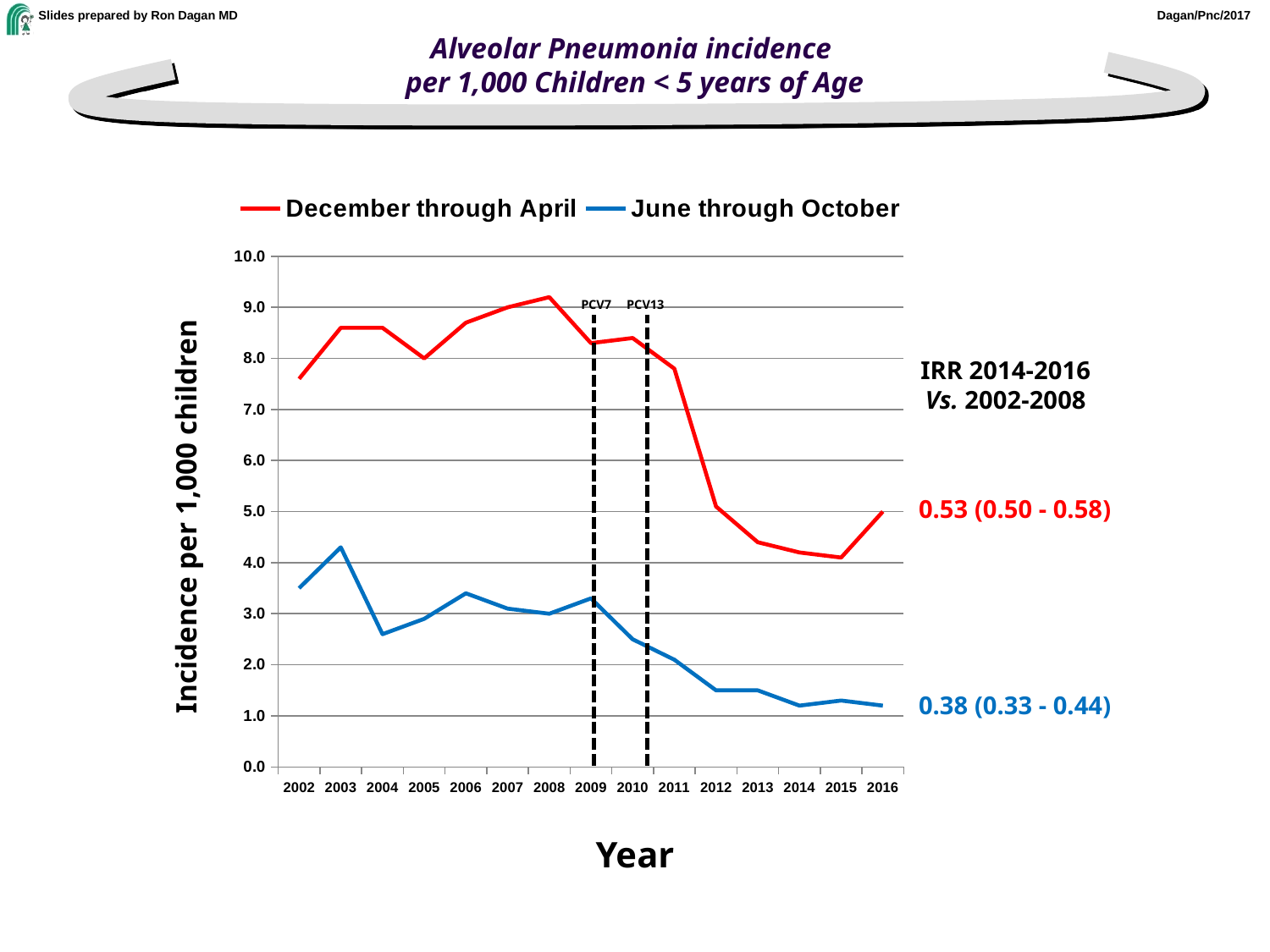
Is the value for June through October in 2004 greater or less than 3.0? less In which year does the June through October series reach its highest value? 2003 Is the value for December through April in 2012 greater or less than 6.0? less Is the value for December through April in 2002 greater or less than 7.0? greater Does the June through October series rise or fall from 2009 to 2016? Fall What kind of chart is shown on the slide? Line chart How many years are plotted along the x axis? 15 What IRR (2014-2016 vs. 2002-2008) is printed next to the December through April line? 0.53 (0.50 - 0.58) How many series does the legend list? 2 In which year does the December through April series reach its highest value? 2008 In 2009, which series has the higher incidence, December through April or June through October? December through April